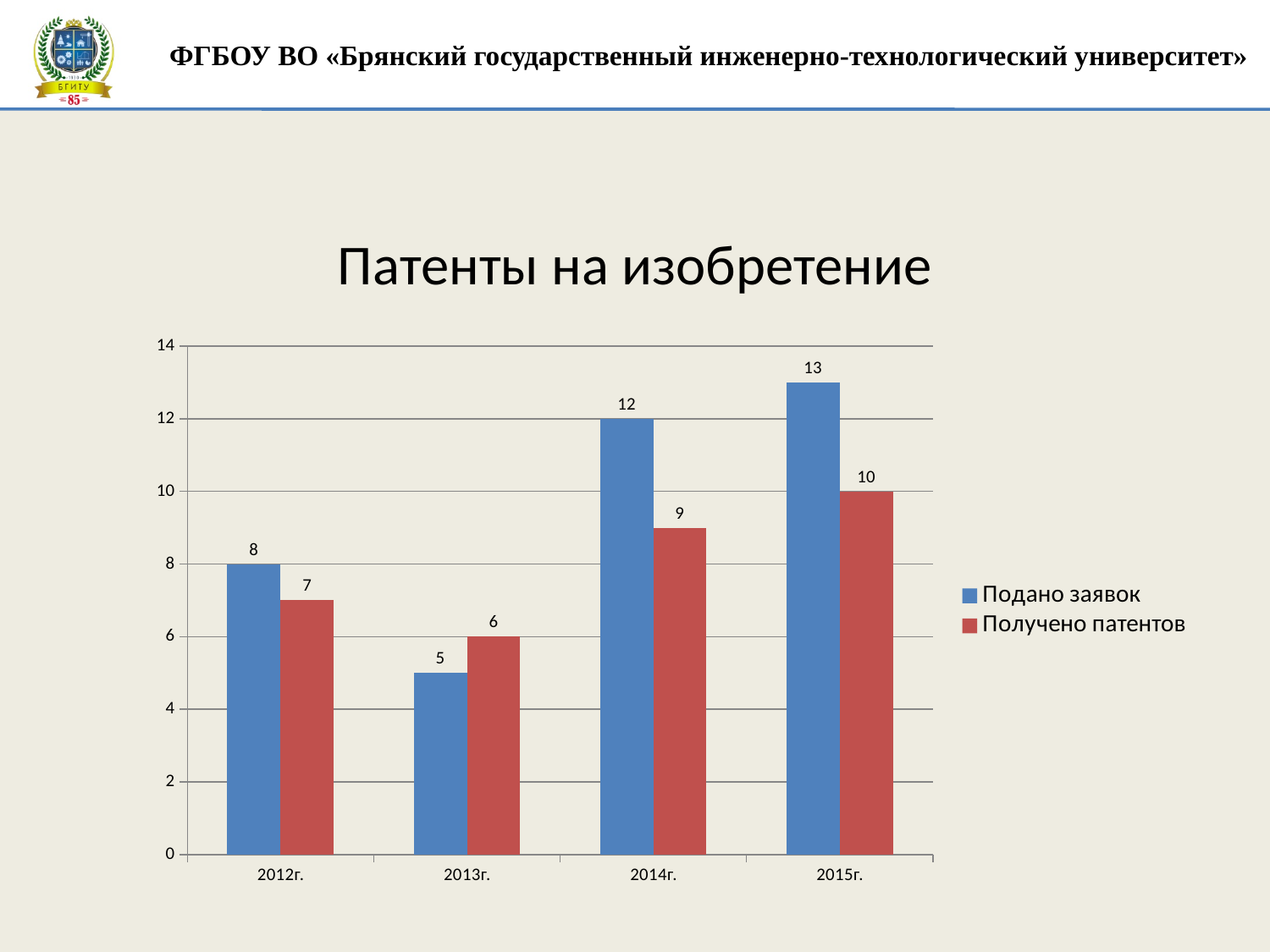
What is the value for 'Подано заявок' in 2014г.? 12 Which year has the lowest value for 'Получено патентов'? 2013г. Does the value for 'Получено патентов' rise or fall from 2013г. to 2015г.? rise What is the value for 'Получено патентов' in 2012г.? 7 In 2013г., which is larger: 'Подано заявок' or 'Получено патентов'? Получено патентов Is the value for 'Подано заявок' in 2015г. greater or less than 12? greater Which year has the highest value for 'Подано заявок'? 2015г. What is the title of the chart? Патенты на изобретение How many series does the legend list? 2 What is the difference between 'Подано заявок' and 'Получено патентов' in 2015г.? 3 What kind of chart is shown on the slide? bar chart How many years are shown on the x axis? 4